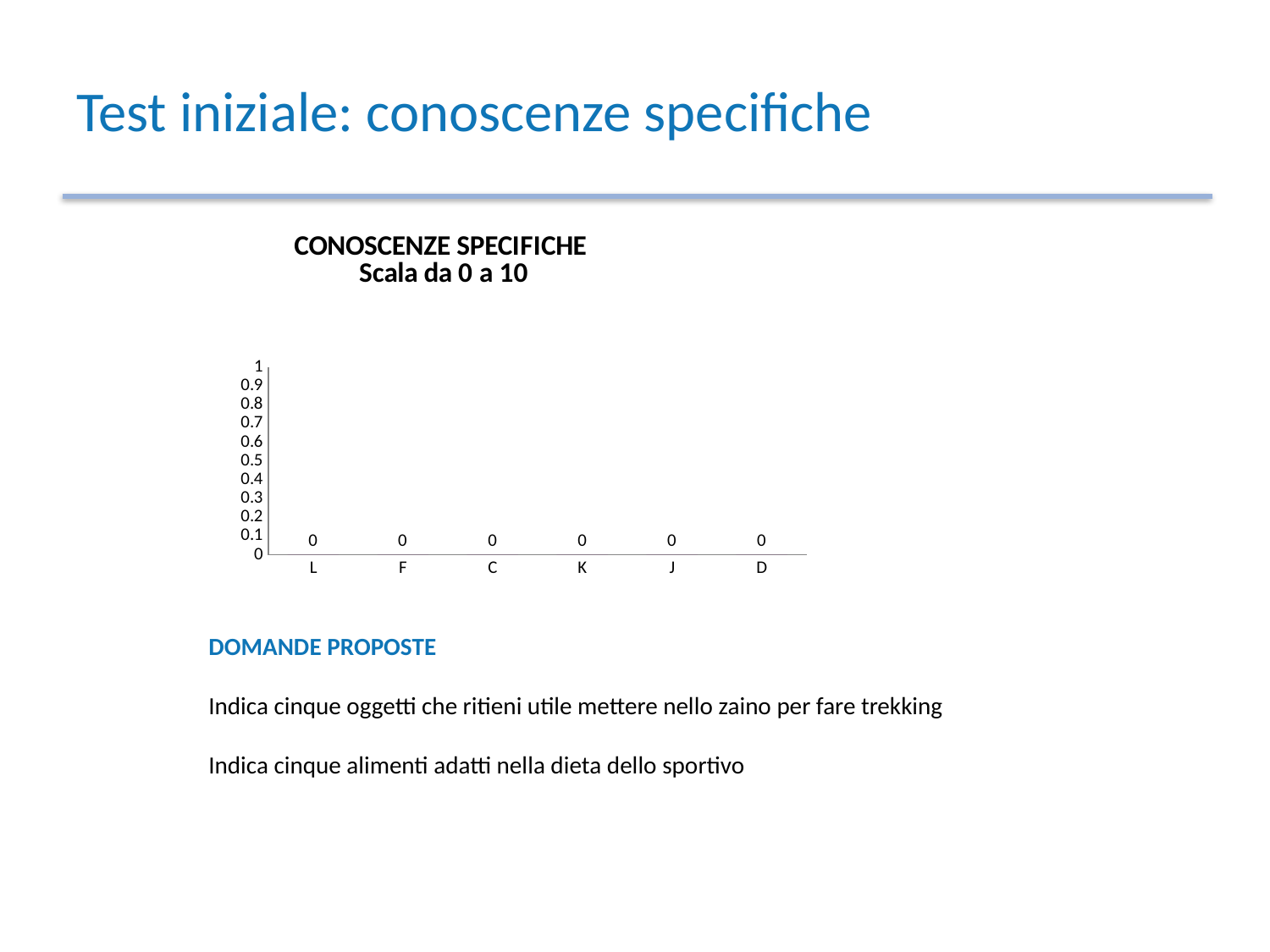
What is the value for K? 0 What is the value for D? 0 What is the value for F? 0 What is the highest tick value shown on the y axis? 1 What is the difference between the values for L and D? 0 What is the value for L? 0 How many categories are shown on the x axis? 6 What is the value for C? 0 What is the title of the chart? CONOSCENZE SPECIFICHE Scala da 0 a 10 Is the value for K greater or less than 0.5? less What is the value for J? 0